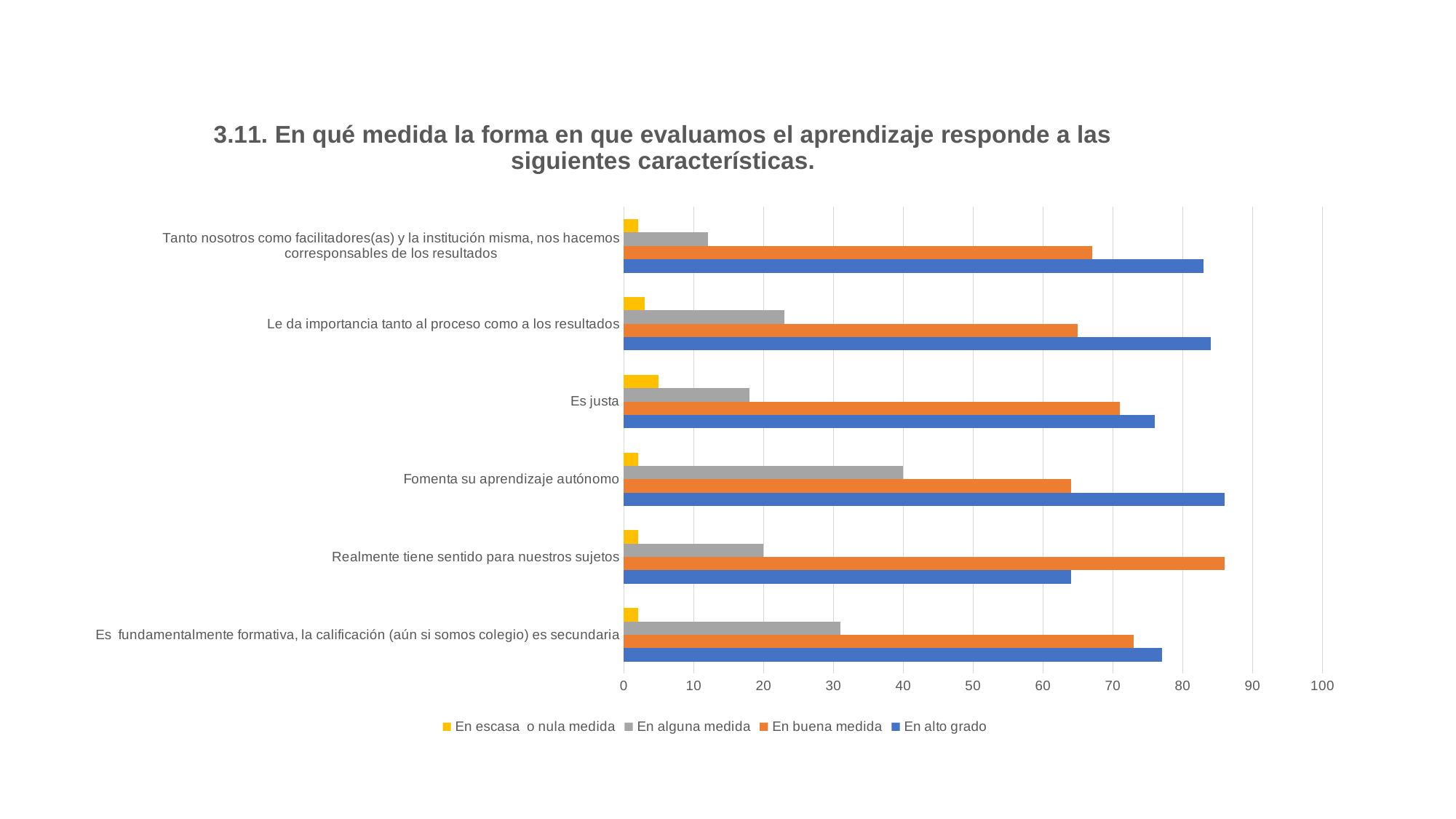
Is the value of 'En alguna medida' for 'Fomenta su aprendizaje autónomo' greater or less than 30? greater For 'Realmente tiene sentido para nuestros sujetos', which is larger: 'En buena medida' or 'En alto grado'? En buena medida How many series does the legend list? 4 Which category has the longest 'En buena medida' bar? Realmente tiene sentido para nuestros sujetos Which category has the longest 'En alguna medida' bar? Fomenta su aprendizaje autónomo How many categories (characteristics) are plotted on the chart? 6 Which series is shown in orange in the legend? En buena medida Is the value of 'En alto grado' for 'Fomenta su aprendizaje autónomo' greater or less than 80? greater What kind of chart is shown on the slide? bar chart Which category has the shortest 'En alguna medida' bar? Tanto nosotros como facilitadores(as) y la institución misma, nos hacemos corresponsables de los resultados Is the value of 'En alto grado' for 'Realmente tiene sentido para nuestros sujetos' greater or less than 70? less